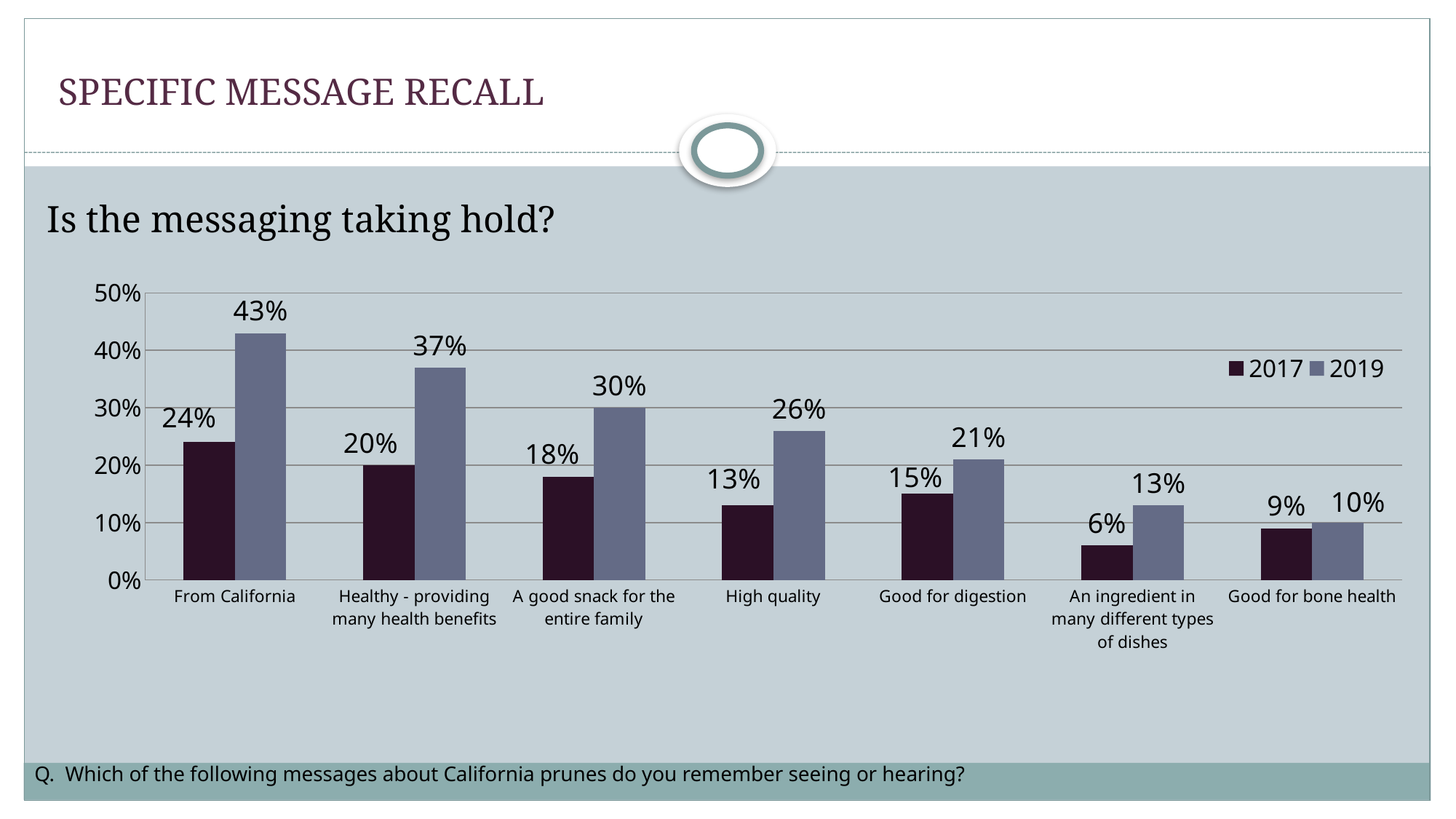
What is the 2019 value for "From California"? 43% Which category has the highest 2019 value? From California What are the two series named in the legend? 2017 and 2019 How many categories are shown on the x axis? 7 How many series does the legend list? 2 What is the difference between the 2019 and 2017 values for "A good snack for the entire family"? 12% Which is larger: the 2019 value for "High quality" or the 2019 value for "Good for digestion"? High quality Which category has the lowest 2017 value? An ingredient in many different types of dishes What kind of chart is shown on the slide? Bar chart What is the 2017 value for "Good for digestion"? 15% What is the difference between the 2019 and 2017 values for "Healthy - providing many health benefits"? 17% What is the 2017 value for "An ingredient in many different types of dishes"? 6%